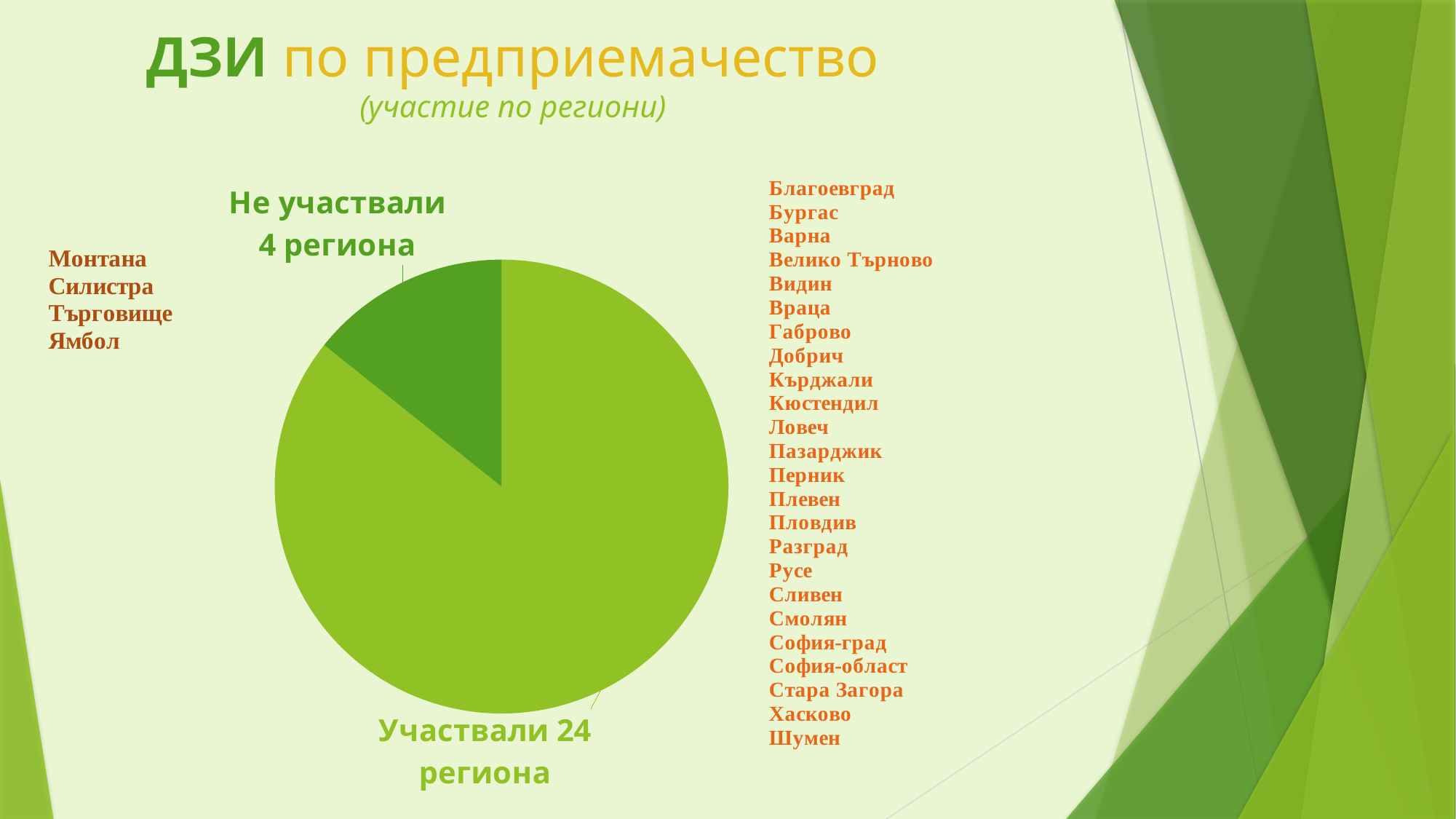
How many regions are in the "Участвали" slice of the pie chart? 24 Which slice of the pie chart is the smallest? Не участвали 4 региона What is the subtitle of the chart shown in parentheses under the main title? (участие по региони) Which of the two pie slices is drawn in the darker green colour? Не участвали 4 региона How many slices does the pie chart have? 2 What kind of chart is shown on the slide? pie chart Which is larger: the "Участвали" slice or the "Не участвали" slice? Участвали How many regions are in the "Не участвали" slice of the pie chart? 4 What is the total number of regions represented in the pie chart? 28 What is the difference between the number of regions that participated and the number that did not participate? 20 Which slice of the pie chart is the largest? Участвали 24 региона